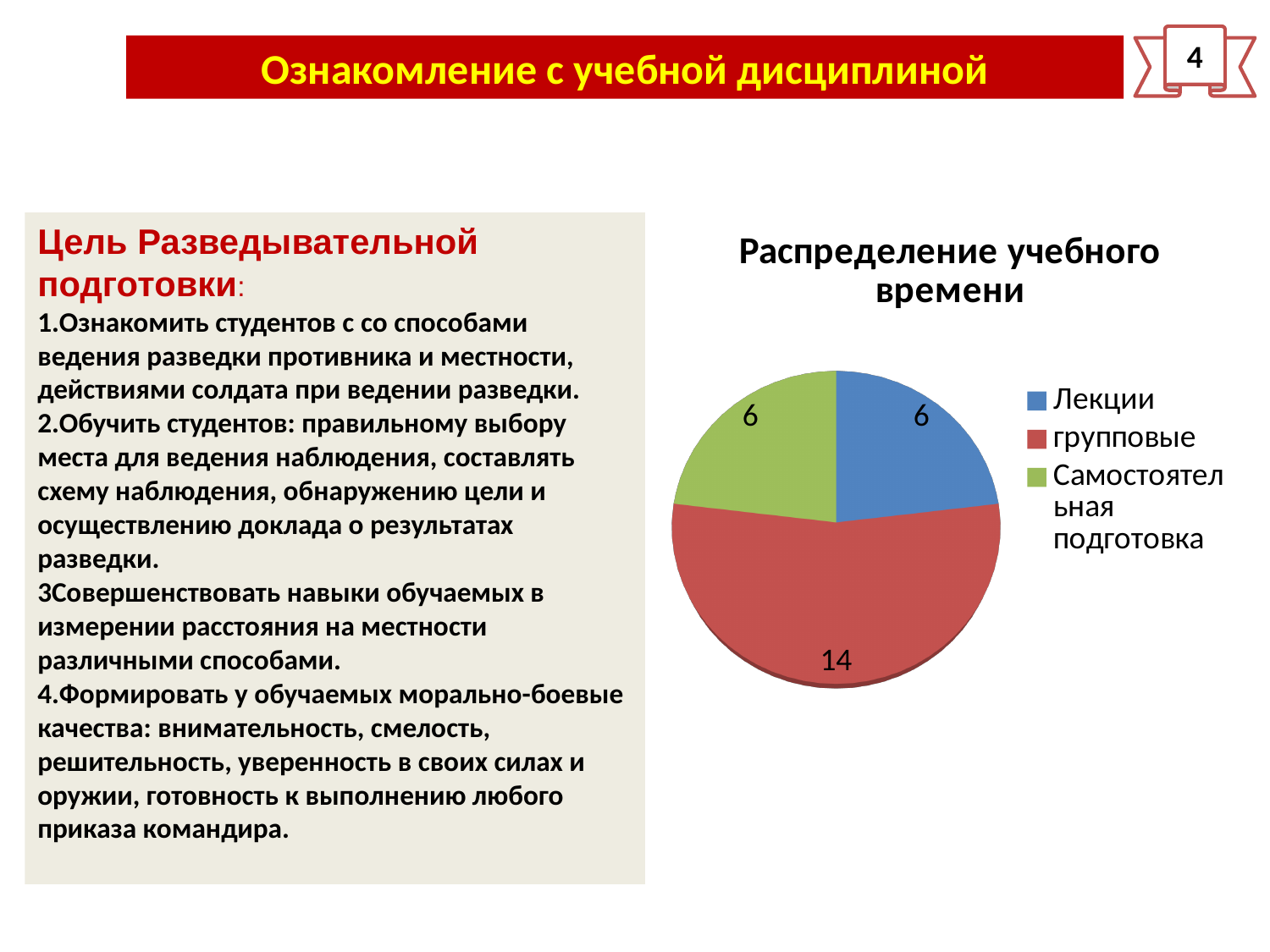
How many entries does the legend list? 3 What is the value for групповые? 14 How many slices does the pie chart have? 3 What is the total of all slices in the pie chart? 26 Which colour represents групповые in the pie chart? red What is the difference between the values for групповые and Лекции? 8 Which category has the largest slice of the pie? групповые What is the title of the chart? Распределение учебного времени Which is larger, the value for групповые or the value for Самостоятельная подготовка? групповые What type of chart is shown on the slide? pie chart What is the value for Самостоятельная подготовка? 6 What is the value for Лекции? 6